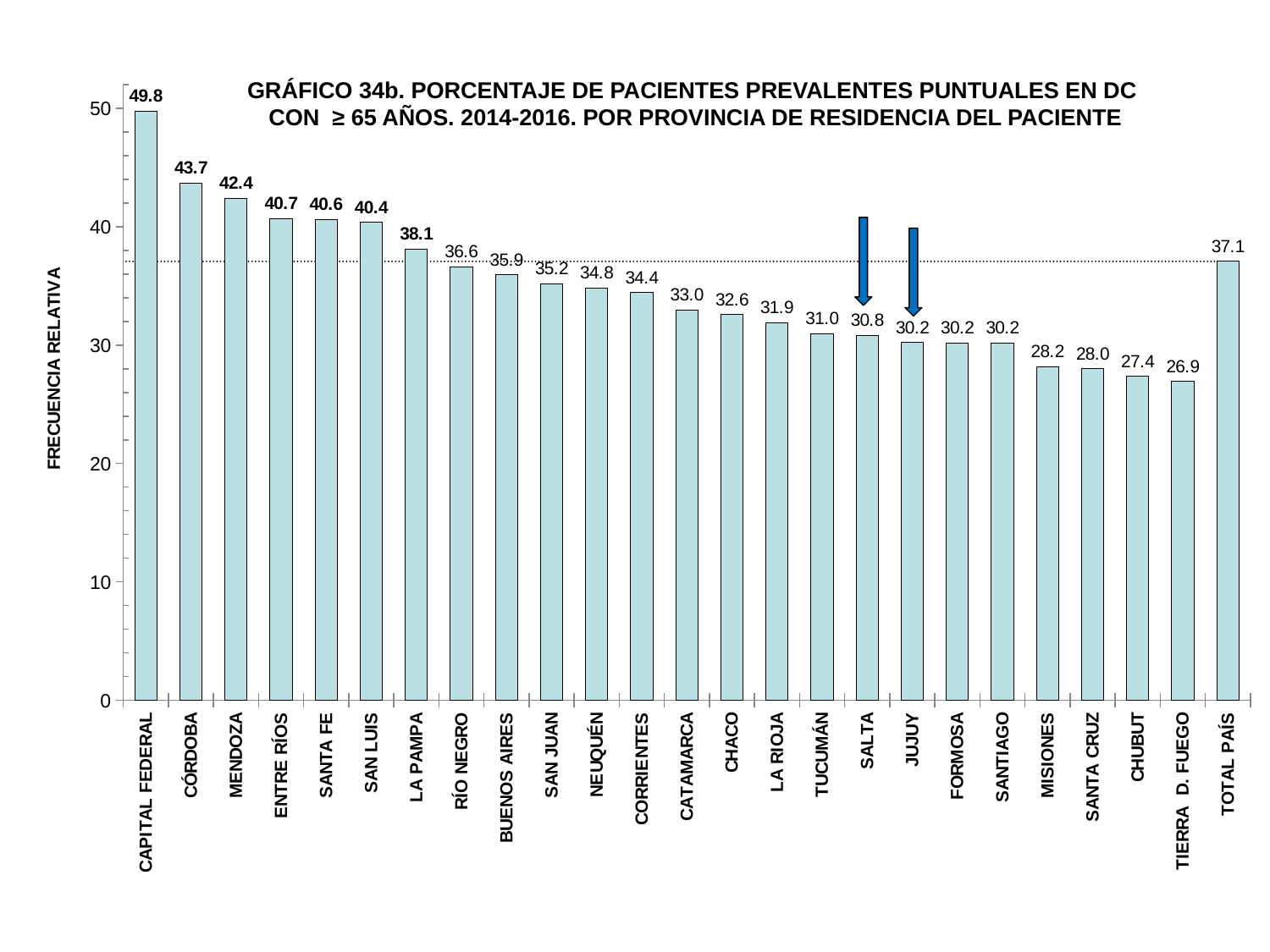
Which is larger, the value for MENDOZA or the value for LA PAMPA? MENDOZA Is the value for CHUBUT greater or less than 30? less How many bars are shown in the chart? 25 What is the value for CAPITAL FEDERAL? 49.8 Which province has the lowest value? TIERRA D. FUEGO What kind of chart is this? bar chart What is the difference between the values for CAPITAL FEDERAL and CÓRDOBA? 6.1 What is the value for TIERRA D. FUEGO? 26.9 What is the value for TOTAL PAÍS? 37.1 What is the value for BUENOS AIRES? 35.9 Which province has the highest value? CAPITAL FEDERAL What is the label of the vertical axis? FRECUENCIA RELATIVA